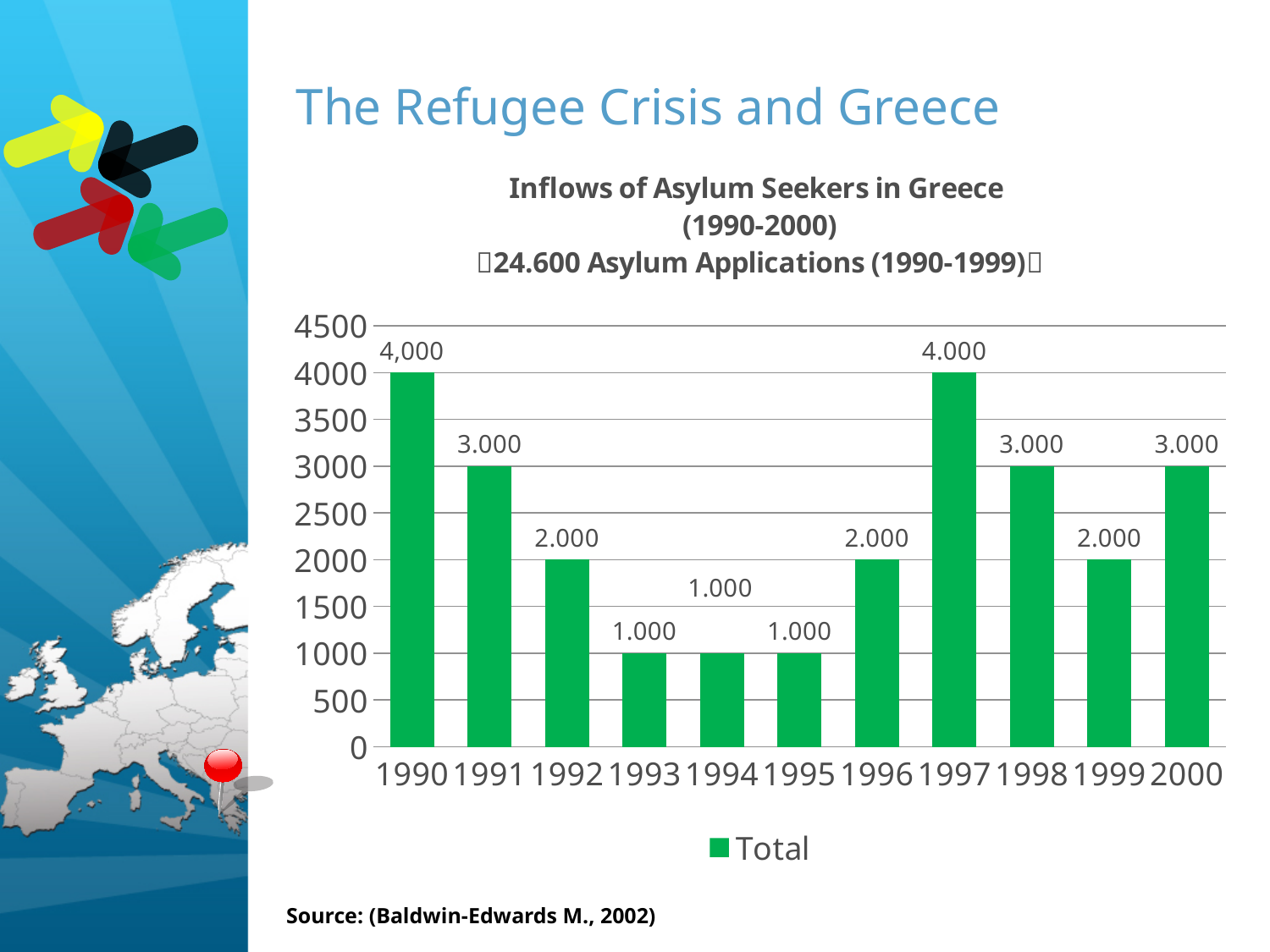
What is the value for 2000? 3.000 How many years are shown on the x axis? 11 What is the difference between the values for 1997 and 1996? 2.000 What is the value for 1993? 1.000 Is the value for 1992 greater or less than 2500? less What is the value for 1997? 4.000 Which year has the larger value, 1998 or 1999? 1998 What kind of chart is shown on the slide? bar chart What is the name of the series in the legend? Total How many series does the legend list? 1 What is the value for 1990? 4,000 Which two years share the highest value on the chart? 1990 and 1997